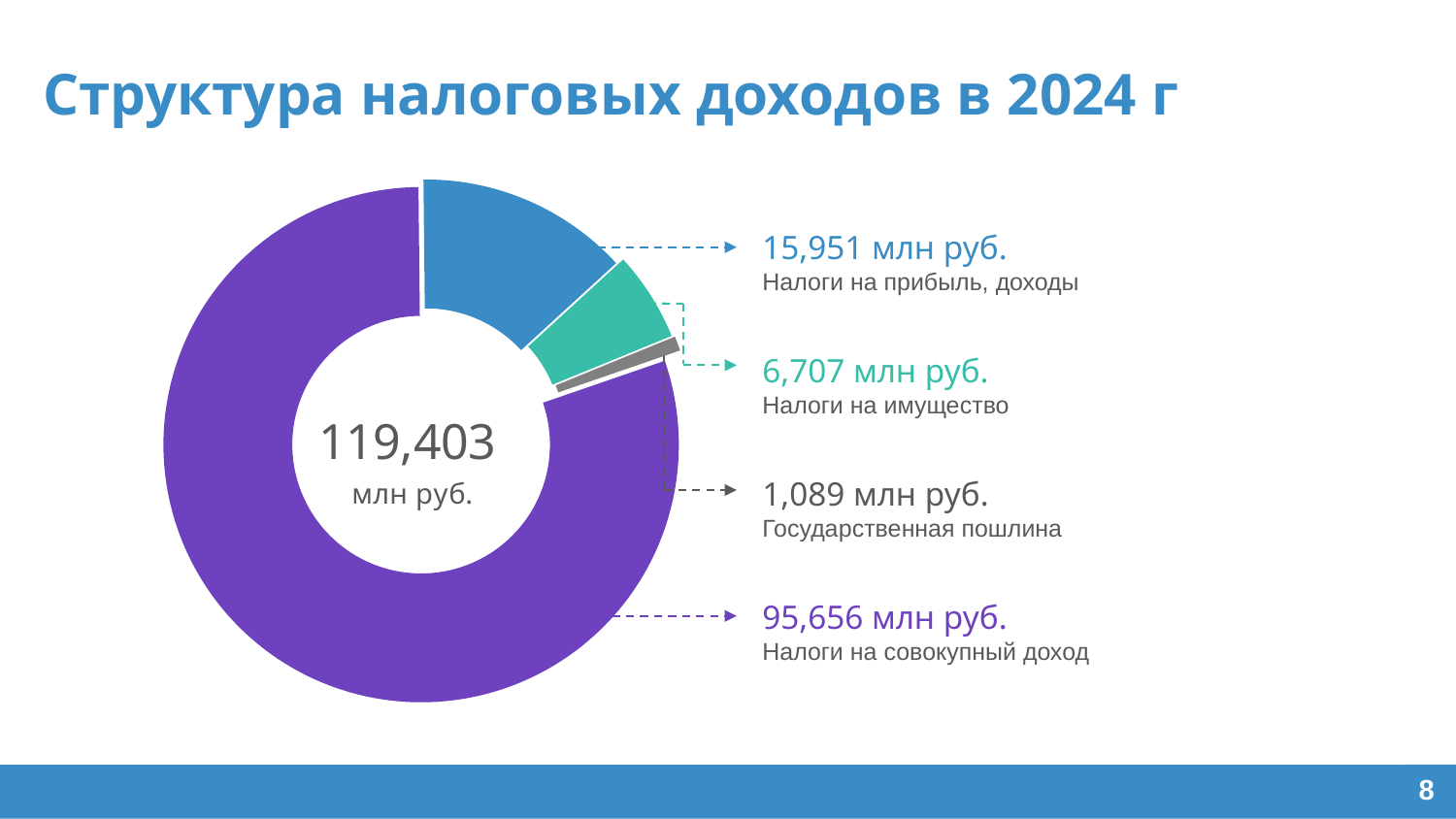
Which is larger: Налоги на имущество or Государственная пошлина? Налоги на имущество What is the value for Государственная пошлина? 1,089 млн руб. Which category has the smallest value? Государственная пошлина What is the value for Налоги на имущество? 6,707 млн руб. What is the value for Налоги на совокупный доход? 95,656 млн руб. What type of chart is shown on the slide? Donut (pie) chart What is the difference between Налоги на совокупный доход and Налоги на прибыль, доходы? 79,705 млн руб. Which category has the largest value? Налоги на совокупный доход How many categories are shown in the chart? 4 What is the difference between Налоги на прибыль, доходы and Налоги на имущество? 9,244 млн руб. What total value is shown in the centre of the donut chart? 119,403 млн руб. What is the value for Налоги на прибыль, доходы? 15,951 млн руб.